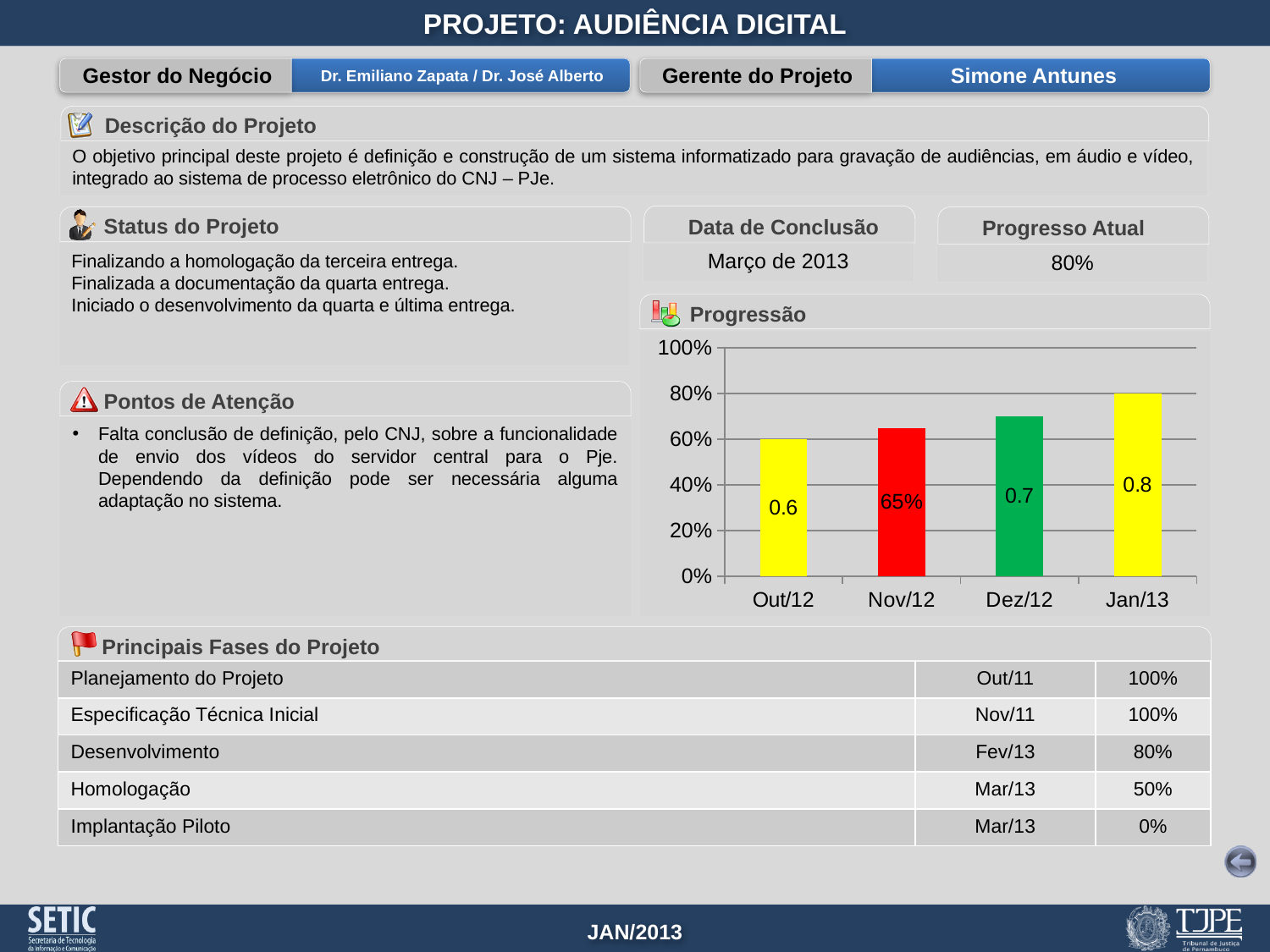
What colour is the Nov/12 bar in the "Progressão" chart? red How many bars are plotted in the "Progressão" chart? 4 Which month has the lowest bar in the "Progressão" chart? Out/12 Which month has the highest bar in the "Progressão" chart? Jan/13 Do the bars in the "Progressão" chart rise or fall from Out/12 to Jan/13? rise What is the data label on the Jan/13 bar in the "Progressão" chart? 0.8 What type of chart is shown under "Progressão"? bar chart What is the data label on the Out/12 bar in the "Progressão" chart? 0.6 What is the data label on the Dez/12 bar in the "Progressão" chart? 0.7 In the "Progressão" chart, is the bar for Dez/12 greater or less than 60%? greater In the "Progressão" chart, is the bar for Nov/12 greater or less than 80%? less What is the data label on the Nov/12 bar in the "Progressão" chart? 65%